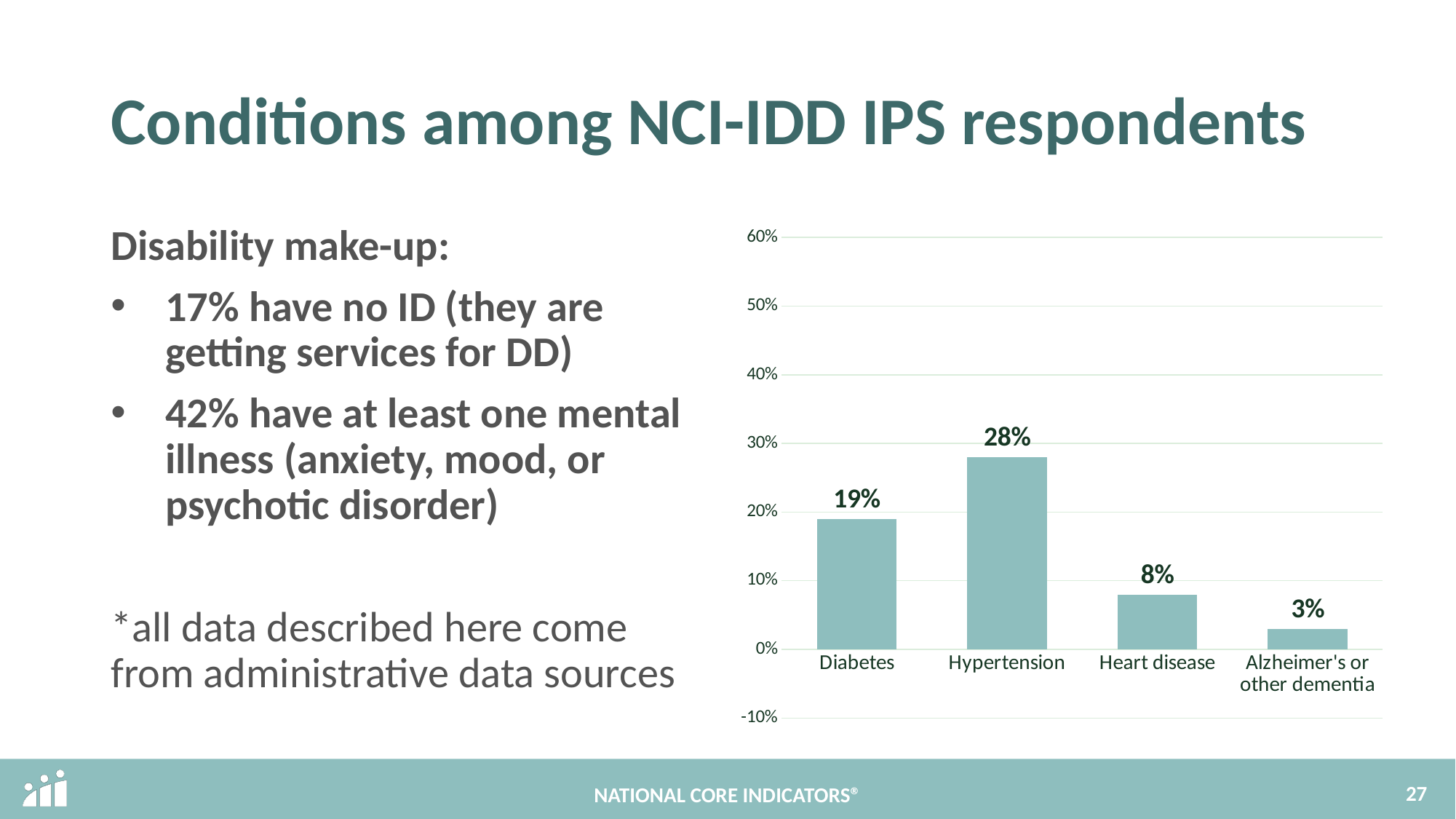
How many conditions are shown in the chart? 4 What kind of chart is shown on the slide? Bar chart What percentage of respondents have hypertension? 28% What percentage of respondents have heart disease? 8% What percentage of respondents have Alzheimer's or other dementia? 3% Which condition has the lowest percentage of respondents? Alzheimer's or other dementia What is the difference in percentage points between heart disease and Alzheimer's or other dementia? 5 percentage points Which condition has the highest percentage of respondents? Hypertension What is the difference in percentage points between hypertension and diabetes? 9 percentage points What percentage of respondents have diabetes? 19% Which is larger, the percentage for diabetes or for heart disease? Diabetes Is the value for hypertension greater or less than 30%? less